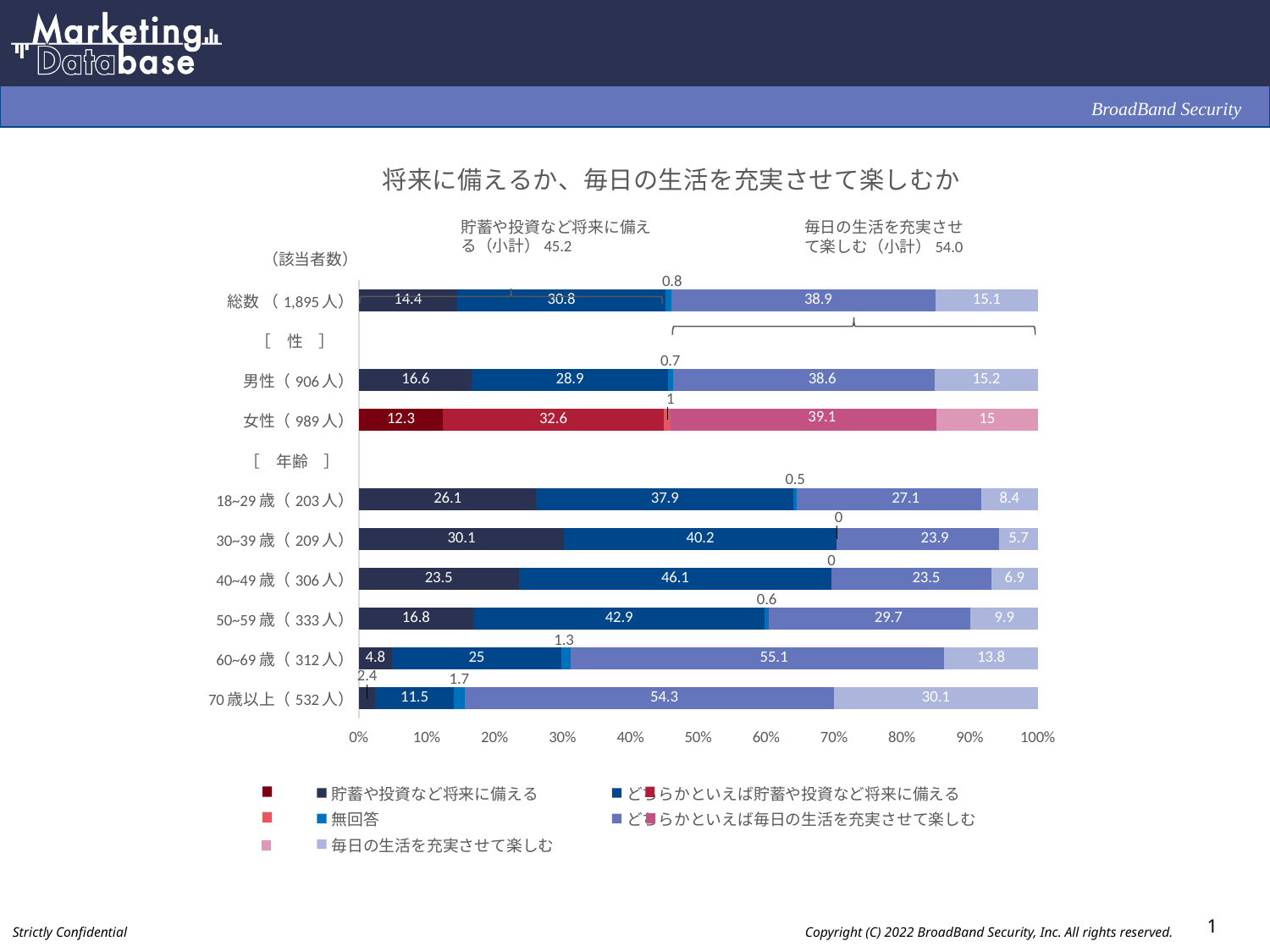
What is the difference between 男性 and 女性 for 「どちらかといえば貯蓄や投資など将来に備える」? 3.7 What type of chart is shown on the slide? Stacked bar chart How many respondent groups (bars) are plotted in the chart? 9 Which age group has the lowest value for 「貯蓄や投資など将来に備える」? 70歳以上 What is the value of 「貯蓄や投資など将来に備える」 for 総数? 14.4 Which age group has the highest value for 「貯蓄や投資など将来に備える」? 30~39歳 What is the subtotal shown for 「貯蓄や投資など将来に備える（小計）」? 45.2 What is the number of respondents shown for 50~59歳? 333人 How many series does the legend list? 5 What is the value of 「どちらかといえば貯蓄や投資など将来に備える」 for 40~49歳? 46.1 Which is larger for 60~69歳: 「どちらかといえば毎日の生活を充実させて楽しむ」 or 「どちらかといえば貯蓄や投資など将来に備える」? どちらかといえば毎日の生活を充実させて楽しむ What is the value of 「毎日の生活を充実させて楽しむ」 for 70歳以上? 30.1